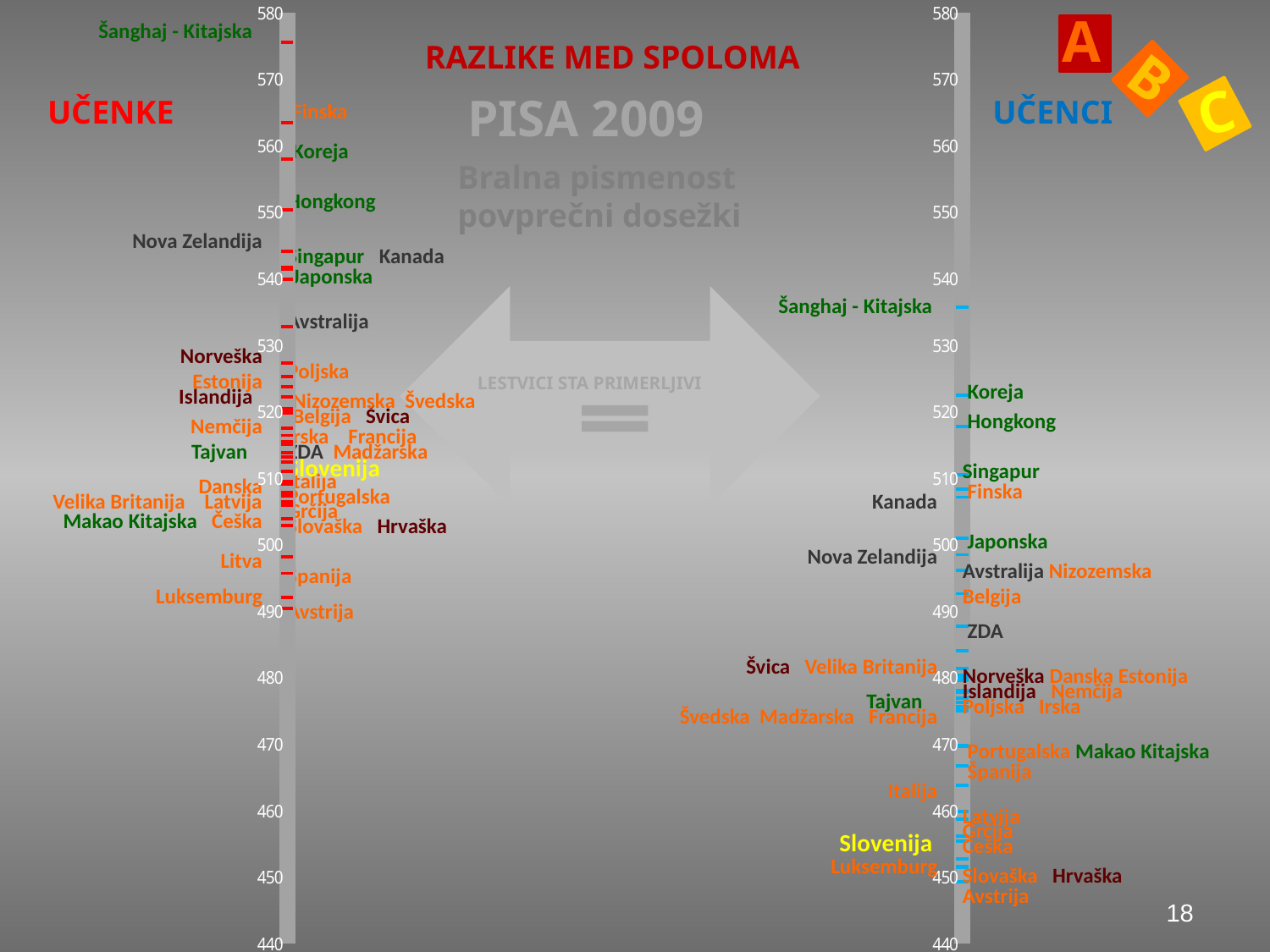
On the left chart (UČENKE), is the value for Finska greater or less than 560? greater On the right chart (UČENCI), which is higher, Koreja or Hongkong? Koreja What are the lowest and highest values shown on the vertical scales? 440 and 580 What is the main title of the slide? RAZLIKE MED SPOLOMA On the left chart (UČENKE), which country is positioned highest on the scale? Šanghaj - Kitajska On the left chart (UČENKE), is the value for Slovenija greater or less than 500? greater On the right chart (UČENCI), which country is positioned lowest on the scale? Avstrija On the right chart (UČENCI), is the value for Koreja greater or less than 520? greater On the left chart (UČENKE), which country is positioned lowest on the scale? Avstrija On the right chart (UČENCI), which country is positioned highest on the scale? Šanghaj - Kitajska